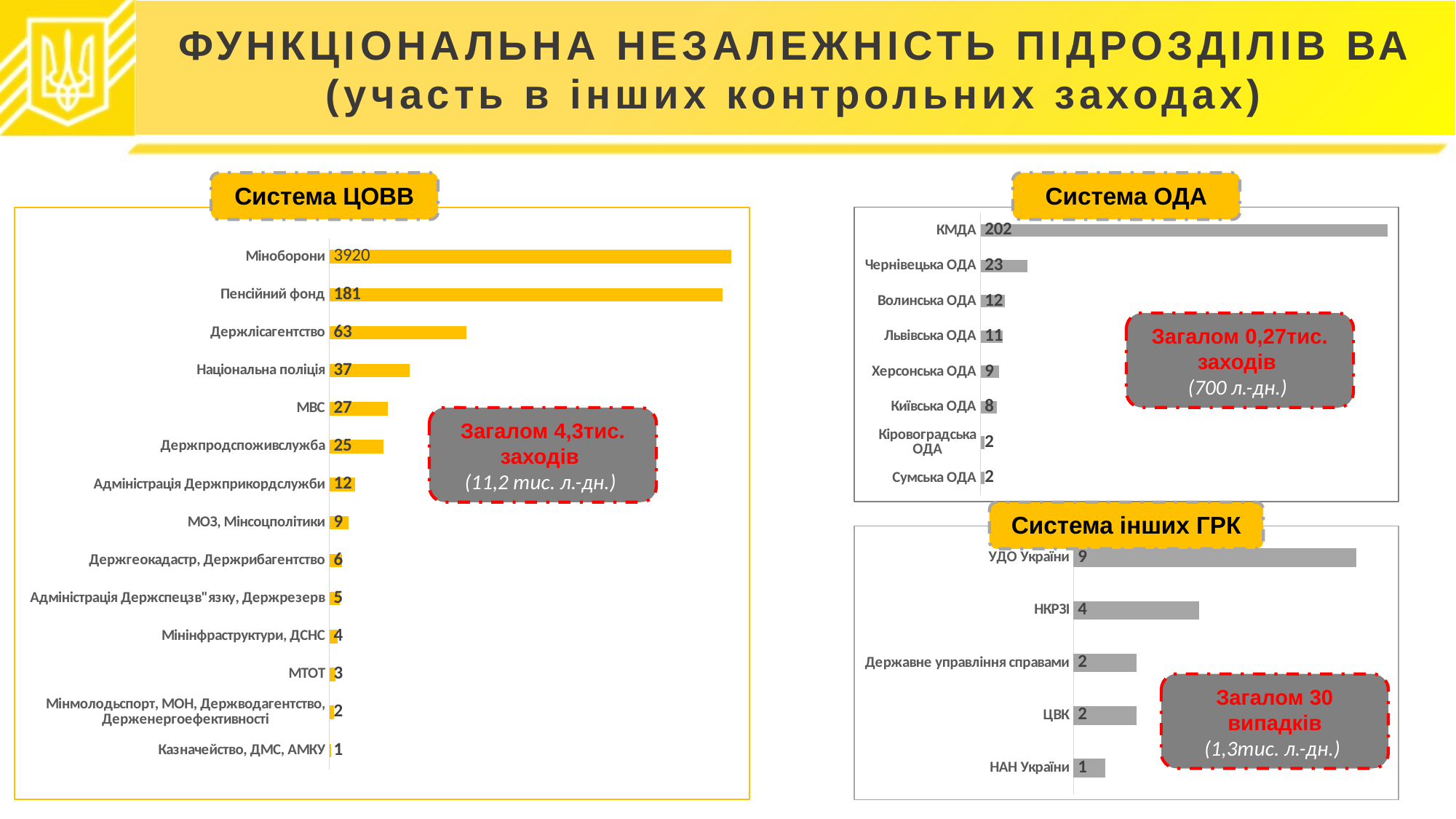
In the "Система ОДА" chart, which is larger, Волинська ОДА or Херсонська ОДА? Волинська ОДА In the "Система ЦОВВ" chart, what is the difference between Пенсійний фонд and Національна поліція? 144 In the "Система ЦОВВ" chart, what is the value for Міноборони? 3920 In the "Система ОДА" chart, what is the value for Чернівецька ОДА? 23 In the "Система ОДА" chart, how many categories are shown? 8 In the "Система ЦОВВ" chart, what is the value for Держлісагентство? 63 In the "Система ЦОВВ" chart, which category has the lowest value? Казначейство, ДМС, АМКУ In the "Система інших ГРК" chart, what is the value for НКРЗІ? 4 In the "Система ЦОВВ" chart, how many categories are shown? 14 In the "Система інших ГРК" chart, what is the difference between УДО України and НАН України? 8 In the "Система ОДА" chart, which category has the highest value? КМДА What kind of chart is the "Система інших ГРК" chart? Bar chart